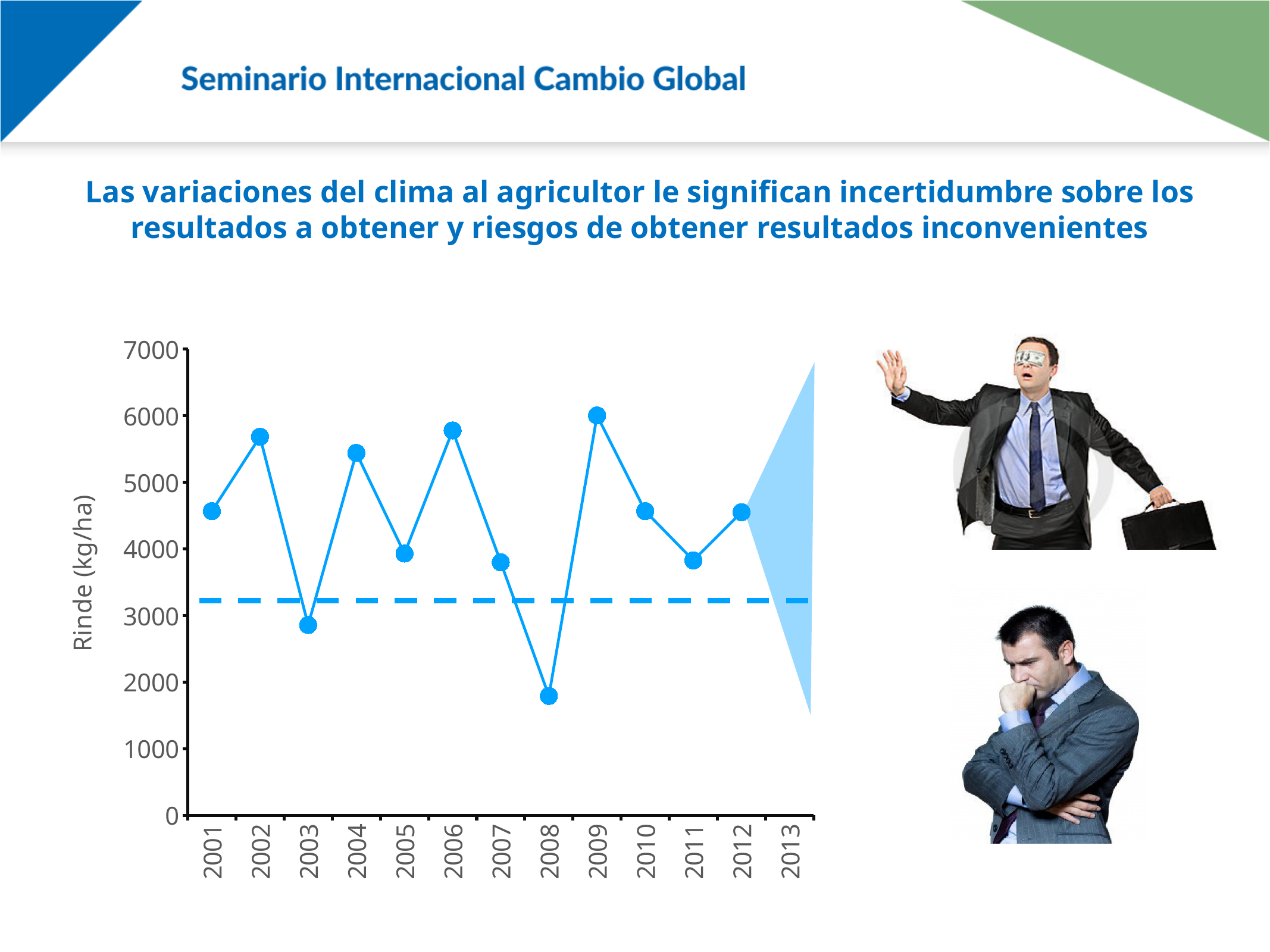
Does the plotted value rise or fall from 2002 to 2003? fall Is the value for 2002 greater or less than 5000? greater Which year has the larger value, 2008 or 2009? 2009 Is the value for 2009 greater or less than 5000? greater Which year has the larger value, 2002 or 2003? 2002 Is the value for 2008 greater or less than 3000? less What kind of chart is shown on the slide? line chart How many years have a plotted data point in the chart? 12 Which year has the lowest plotted value in the chart? 2008 What is the label of the vertical axis of the chart? Rinde (kg/ha) Which year has the highest plotted value in the chart? 2009